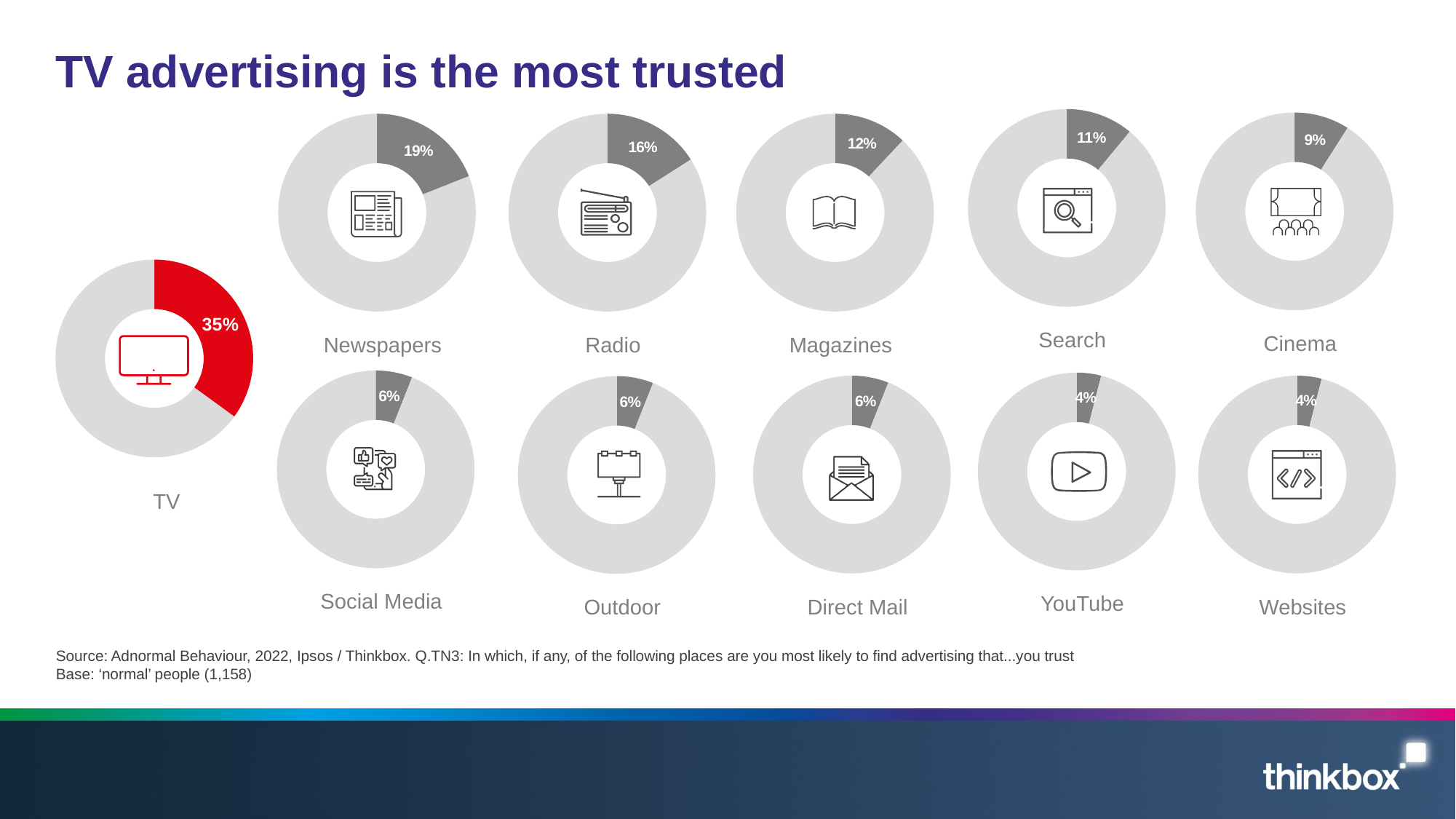
What kind of chart is used for each medium on the slide? Donut chart How many media are shown with donut charts on the slide? 11 Which is larger, the percentage for Radio or the percentage for Magazines? Radio What percentage is shown for Radio? 16% What percentage is shown for Cinema? 9% What is the difference between the Magazines percentage and the Search percentage? 1% Which medium has the highest percentage? TV Which media share the lowest percentage of 4%? YouTube and Websites What percentage is shown for Newspapers? 19% What percentage is shown for TV? 35% What is the difference between the TV percentage and the Newspapers percentage? 16% Which medium's donut chart is highlighted in red? TV